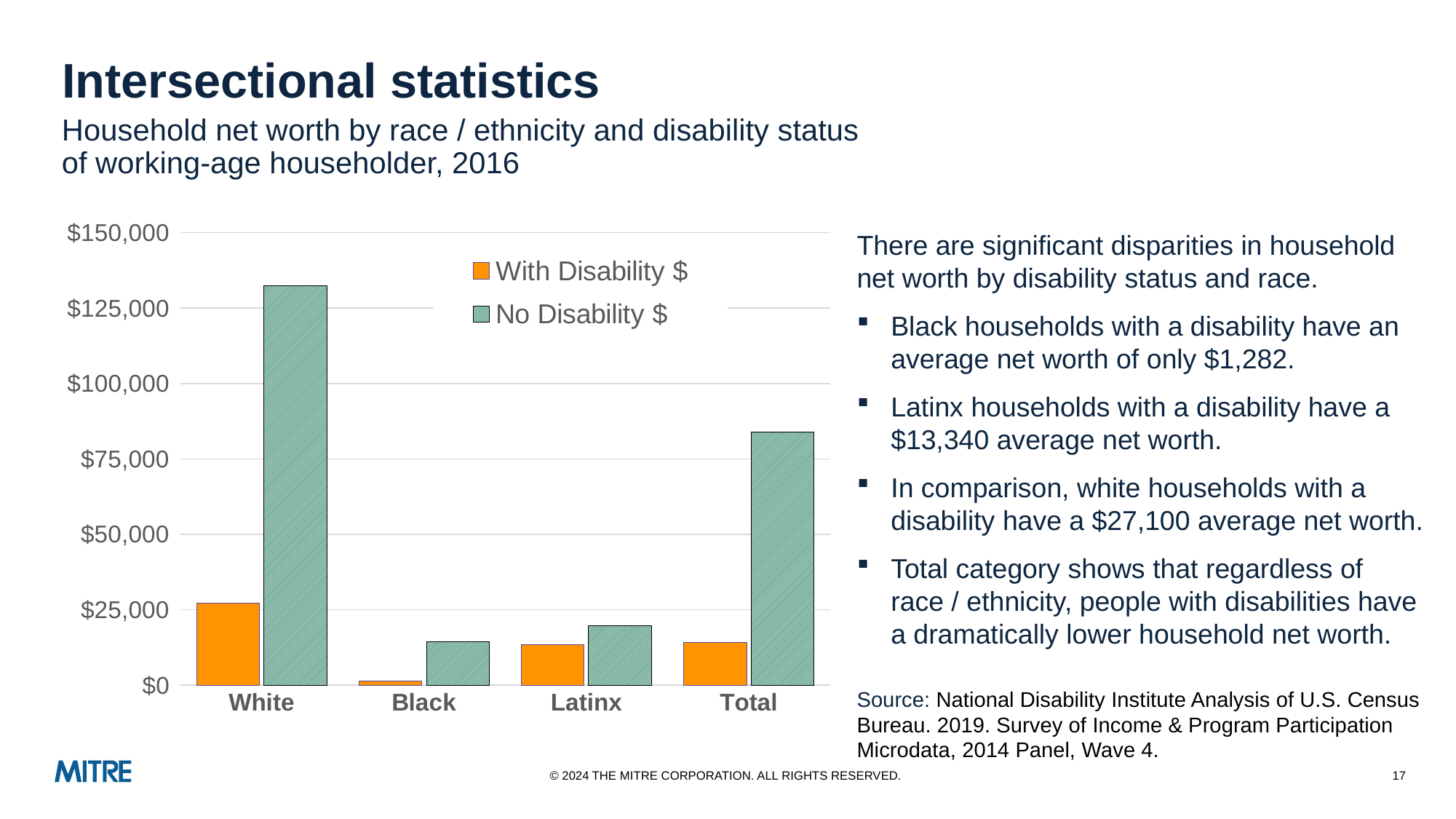
How many series does the chart legend list? 2 According to the slide, what is the average net worth of Black households with a disability? $1,282 What kind of chart is shown on the slide? bar chart Is the No Disability $ value for White greater or less than $125,000? greater Is the With Disability $ value for Total greater or less than $25,000? less Is the No Disability $ value for Black greater or less than $25,000? less How many race / ethnicity categories are shown on the x axis of the chart? 4 Which series is shown in orange in the chart legend? With Disability $ Which is larger: the No Disability $ value for White or the No Disability $ value for Total? White Which category has the lowest With Disability $ value? Black Which category has the highest No Disability $ value? White